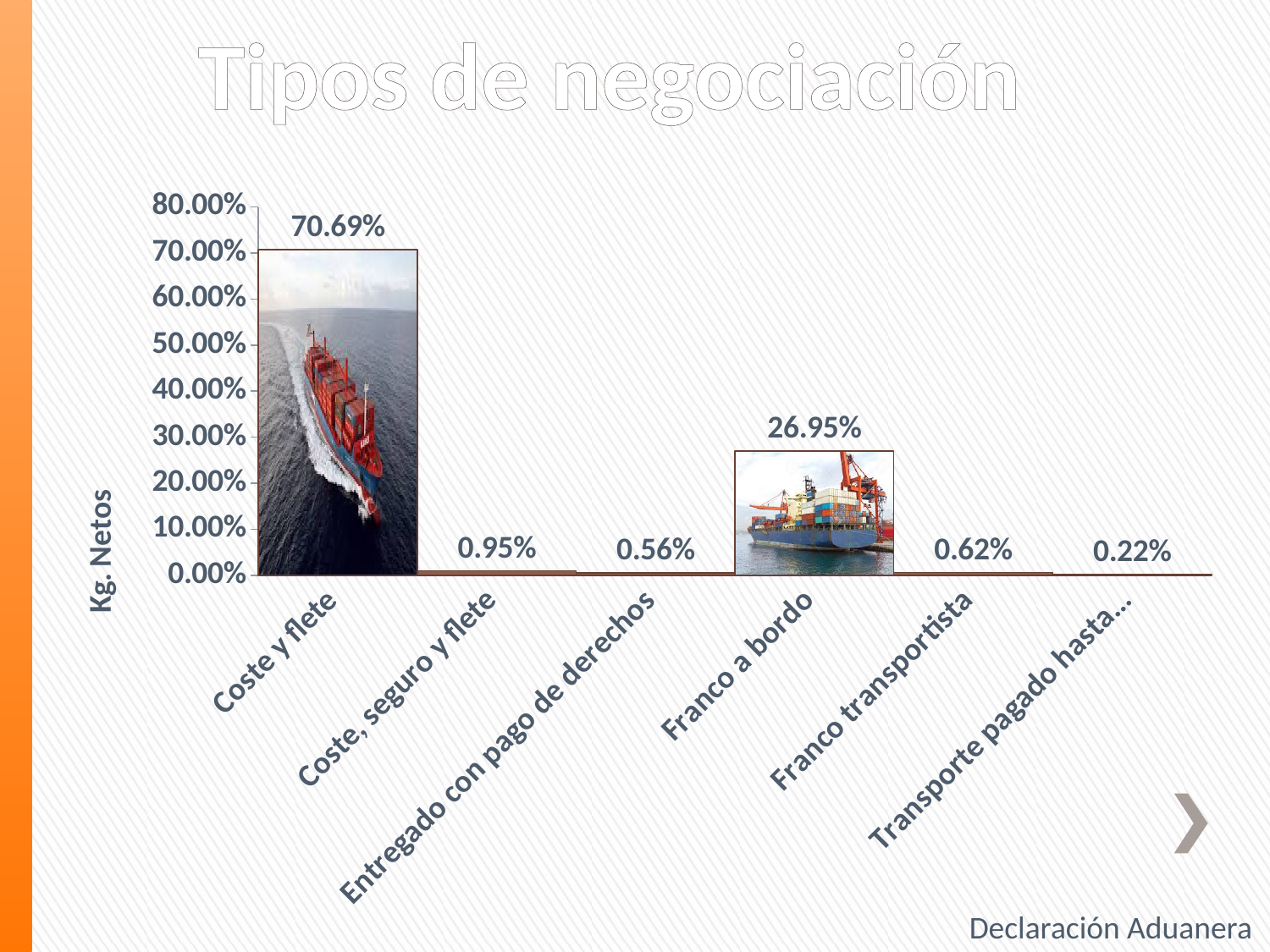
What kind of chart is shown on the slide? Bar chart Which is larger, the value for Coste, seguro y flete or the value for Franco transportista? Coste, seguro y flete What is the value for Coste, seguro y flete? 0.95% What is the value for Entregado con pago de derechos? 0.56% How many categories are shown on the x axis? 6 What is the label of the vertical axis? Kg. Netos What is the value for Franco a bordo? 26.95% What is the difference between the values for Coste y flete and Franco a bordo? 43.74% What is the value for Franco transportista? 0.62% What is the value for Coste y flete? 70.69% Which category has the highest value? Coste y flete Which category has the lowest value? Transporte pagado hasta...